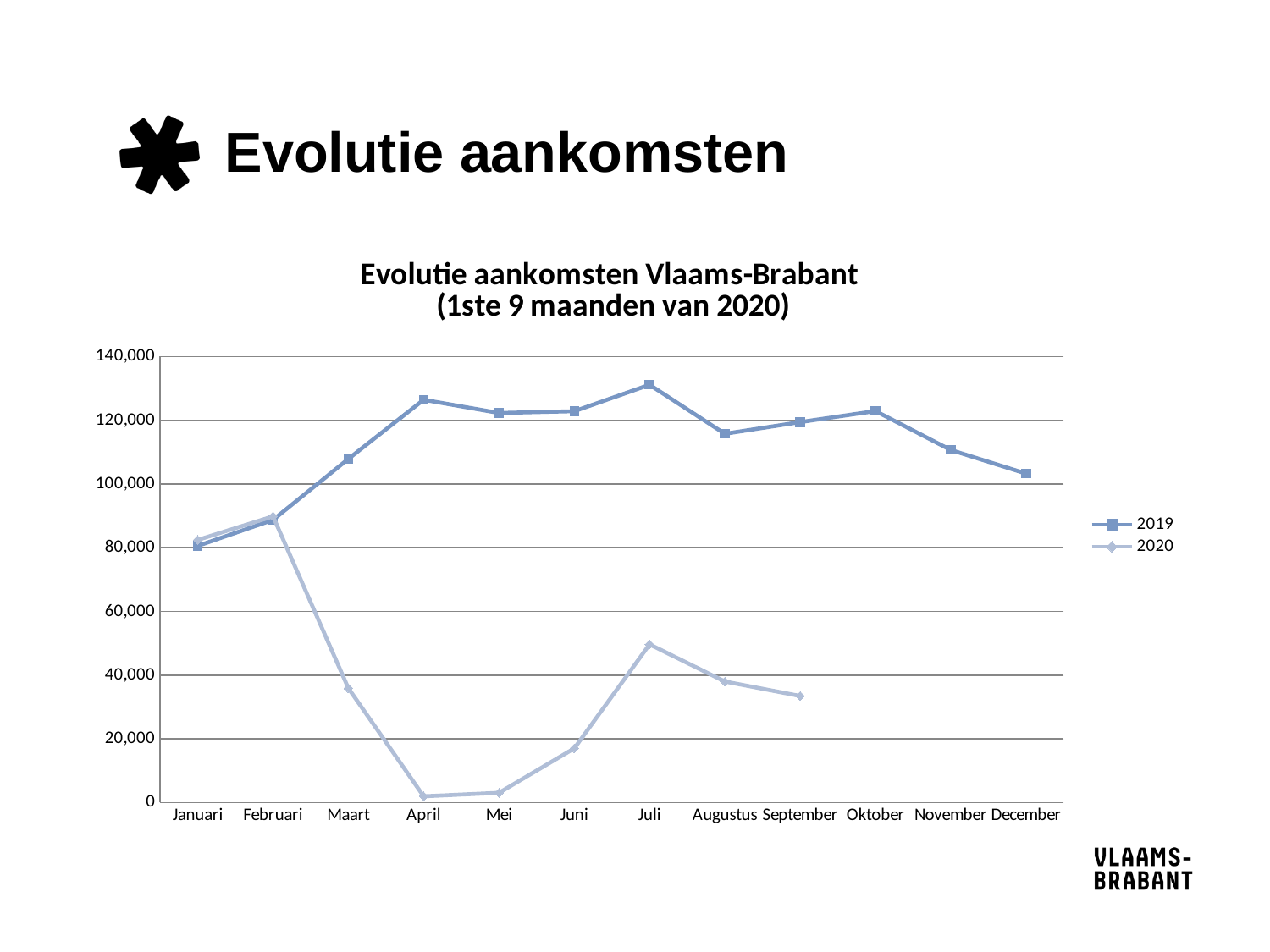
What kind of chart is shown on the slide? line chart In which month does the 2020 series reach its highest value? Februari How many months are shown on the x axis? 12 In which month does the 2019 series reach its highest value? Juli Does the 2020 series rise or fall from Februari to April? fall Which series has the larger value in Juli, 2019 or 2020? 2019 How many series does the legend list? 2 Is the 2019 value for Juli greater or less than 120,000? greater Is the 2020 value for Juli greater or less than 40,000? greater Is the 2020 value for April greater or less than 20,000? less How many data points does the 2020 series have? 9 In which month is the 2019 series at its lowest value? Januari